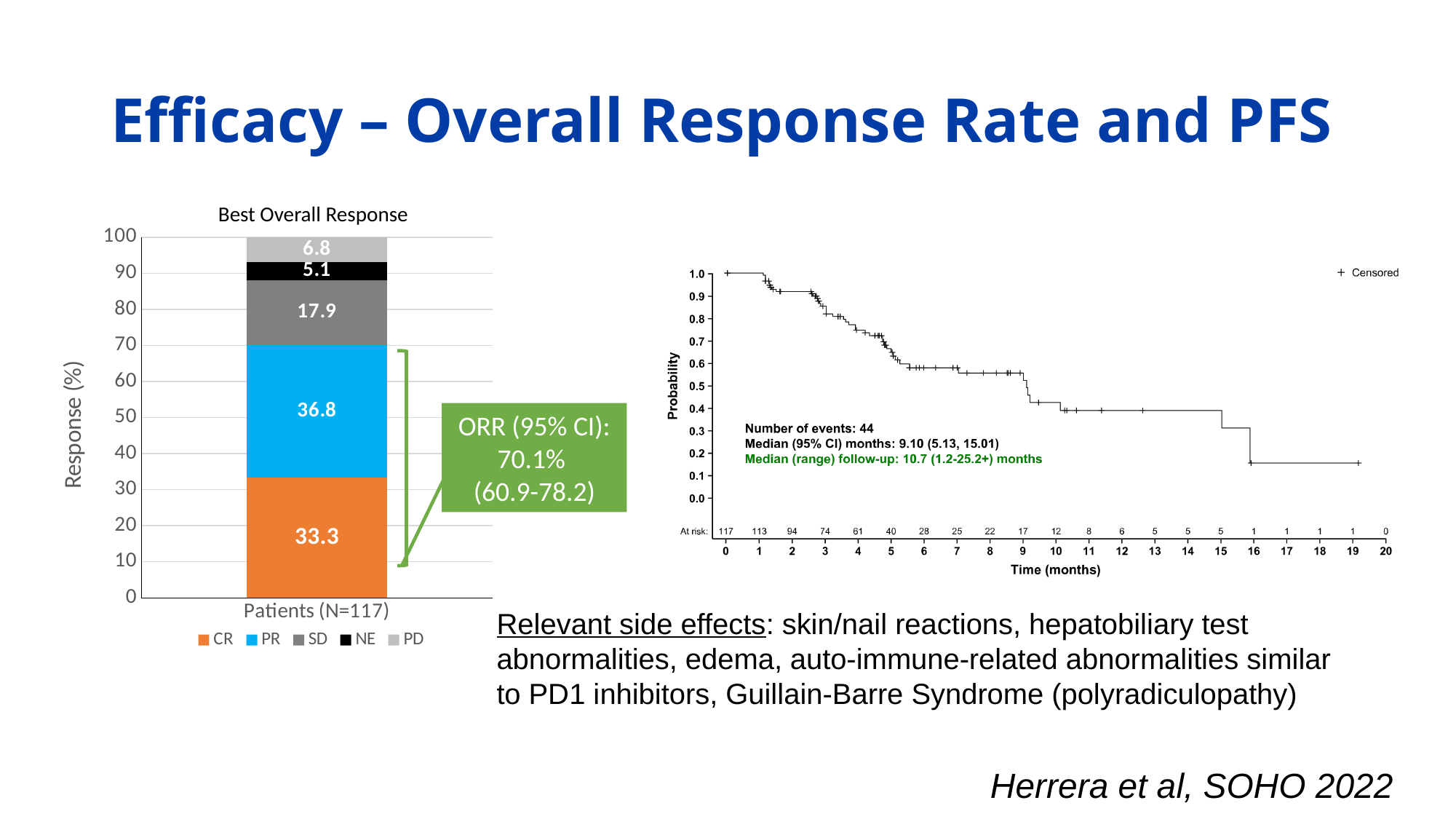
In the Best Overall Response chart, which response category has the largest value? PR In the Best Overall Response chart, what ORR (95% CI) is shown in the green box? 70.1% (60.9-78.2) In the PFS curve on the right, is the probability at 10 months greater or less than 0.5? less In the Best Overall Response chart, what is the value for PR? 36.8 In the Best Overall Response chart, what is the value for CR? 33.3 In the PFS curve on the right, how many patients are at risk at 5 months? 40 What kind of chart is the Best Overall Response chart? Stacked bar chart In the Best Overall Response chart, what is the difference between the PR and CR values? 3.5 How many series does the legend of the Best Overall Response chart list? 5 In the Best Overall Response chart, what is the value for NE? 5.1 In the Best Overall Response chart, which is larger, SD or PD? SD In the Best Overall Response chart, which response category has the smallest value? NE